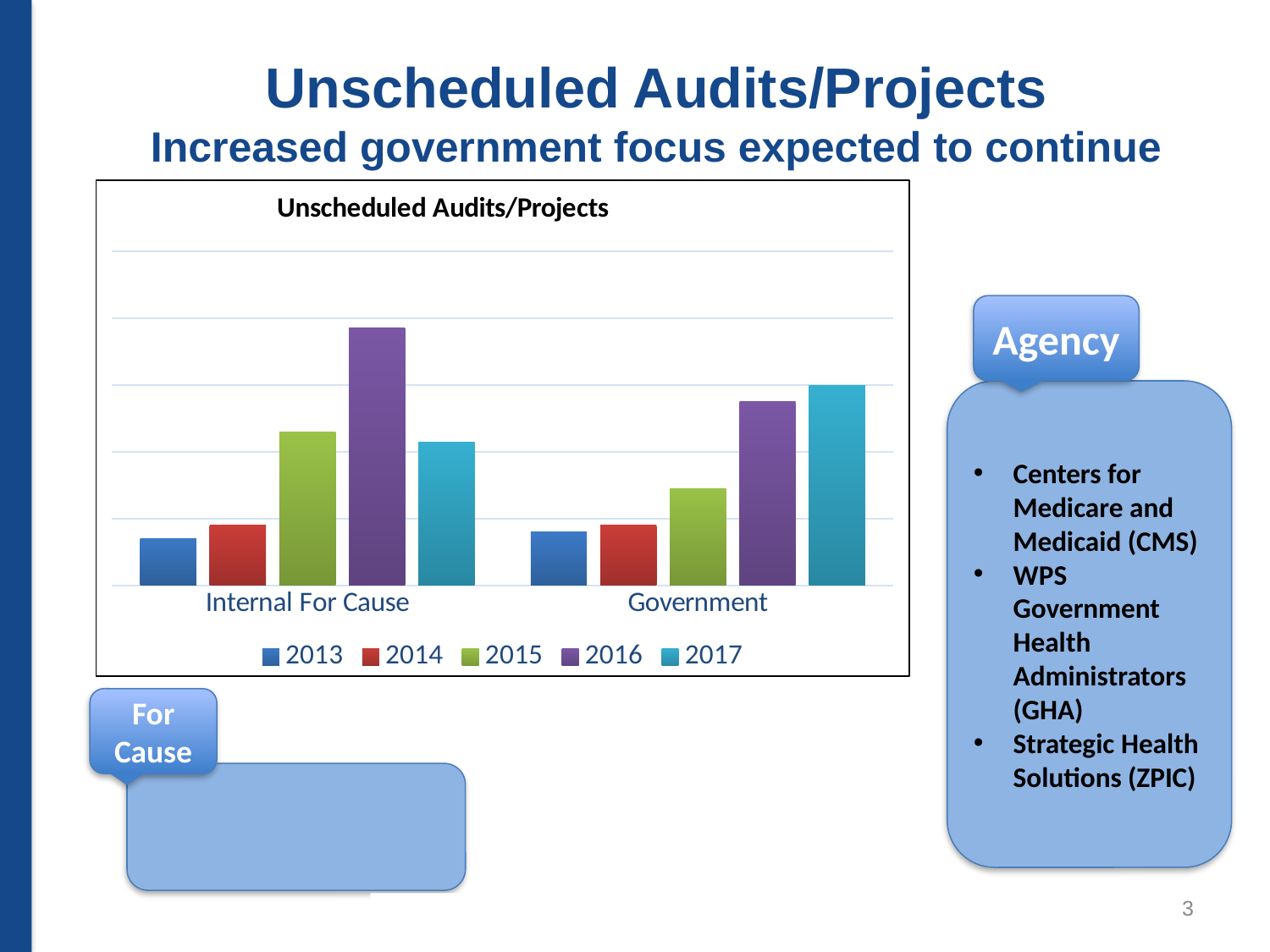
Which years are listed in the chart's legend? 2013, 2014, 2015, 2016, 2017 For 2017, which category has the larger value, Internal For Cause or Government? Government In the Government category, do the values generally rise or fall from 2013 to 2017? rise What is the title of the chart? Unscheduled Audits/Projects What kind of chart is shown on the slide? bar chart For 2016, which category has the larger value, Internal For Cause or Government? Internal For Cause How many series does the chart's legend list? 5 In the Internal For Cause category, which year has the highest bar? 2016 In the Internal For Cause category, which year has the lowest bar? 2013 How many categories are shown on the x axis of the chart? 2 For 2015, which category has the larger value, Internal For Cause or Government? Internal For Cause In the Government category, which year has the highest bar? 2017